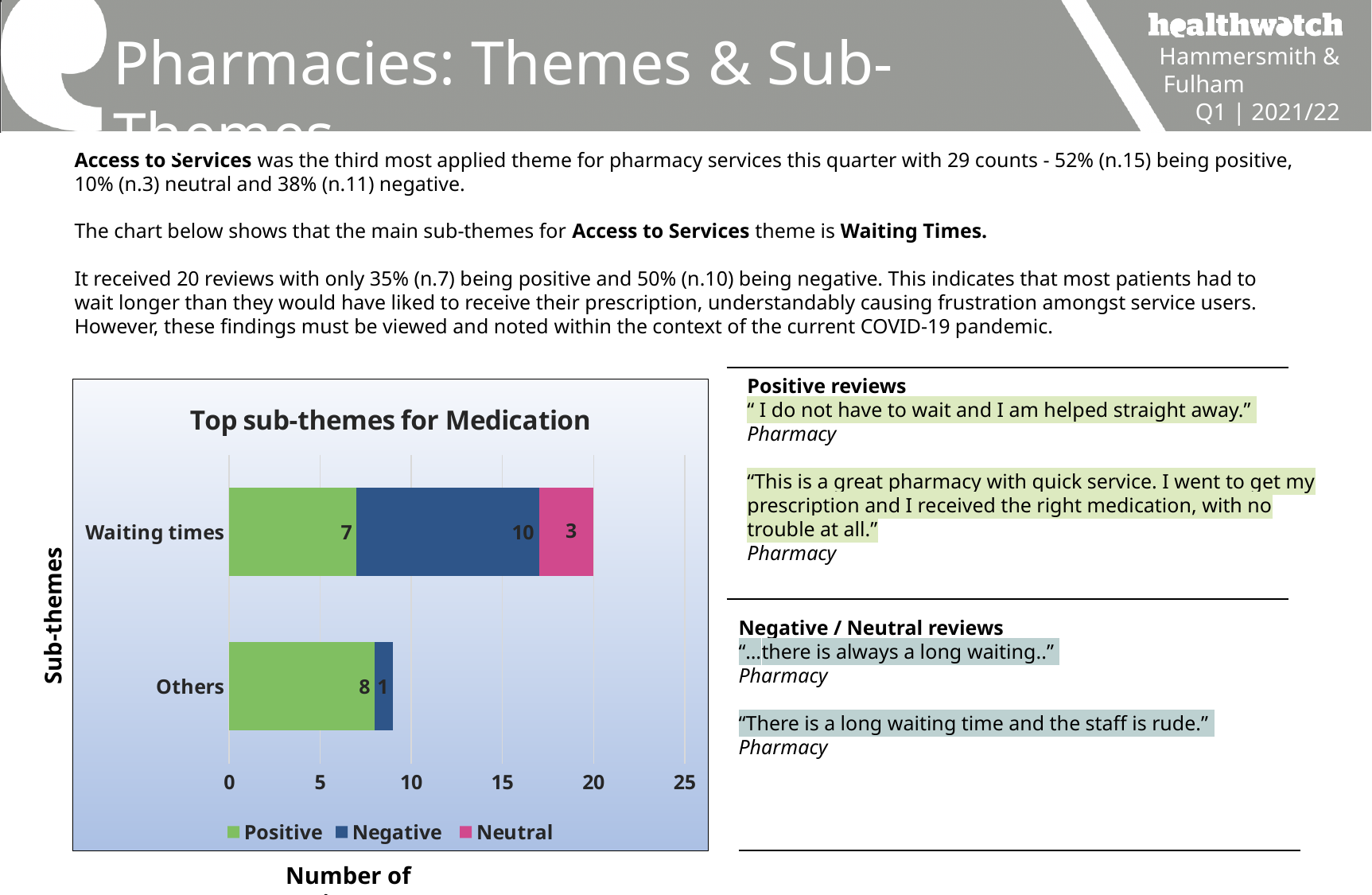
What is the Neutral value for Waiting times? 3 How many sub-theme categories are shown on the chart? 2 What is the Positive value for Others? 8 What is the Positive value for Waiting times? 7 What is the total of the stacked bar for Waiting times? 20 What is the Negative value for Others? 1 What type of chart is 'Top sub-themes for Medication'? Stacked bar chart What is the title of the chart? Top sub-themes for Medication How many series does the legend list? 3 Which sub-theme has the larger Positive value, Waiting times or Others? Others What is the Negative value for Waiting times? 10 What is the difference between the Negative values for Waiting times and Others? 9